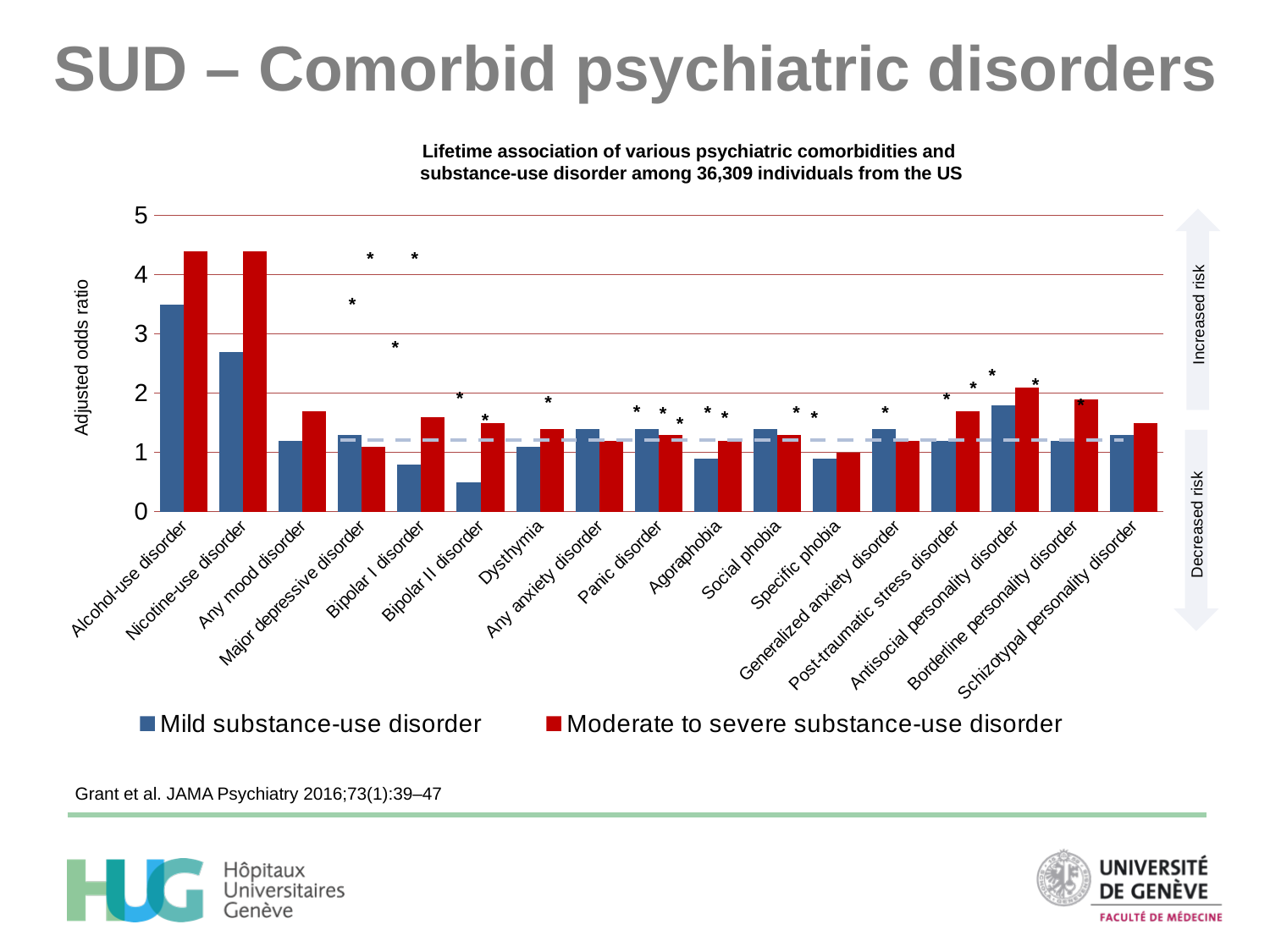
Is the adjusted odds ratio for mild substance-use disorder in Bipolar II disorder greater or less than 1? less What kind of chart is shown on the slide? bar chart For Bipolar II disorder, which series has the larger adjusted odds ratio: mild substance-use disorder or moderate to severe substance-use disorder? Moderate to severe substance-use disorder Is the adjusted odds ratio for moderate to severe substance-use disorder in Major depressive disorder greater or less than 2? less What is the label of the y axis of the chart? Adjusted odds ratio For Alcohol-use disorder, which series has the larger adjusted odds ratio: mild substance-use disorder or moderate to severe substance-use disorder? Moderate to severe substance-use disorder Which category has the lowest adjusted odds ratio for mild substance-use disorder? Bipolar II disorder Which category has the highest adjusted odds ratio for mild substance-use disorder? Alcohol-use disorder Is the adjusted odds ratio for mild substance-use disorder in Nicotine-use disorder greater or less than 2? greater How many psychiatric disorder categories are plotted along the x axis? 17 How many series does the legend list? 2